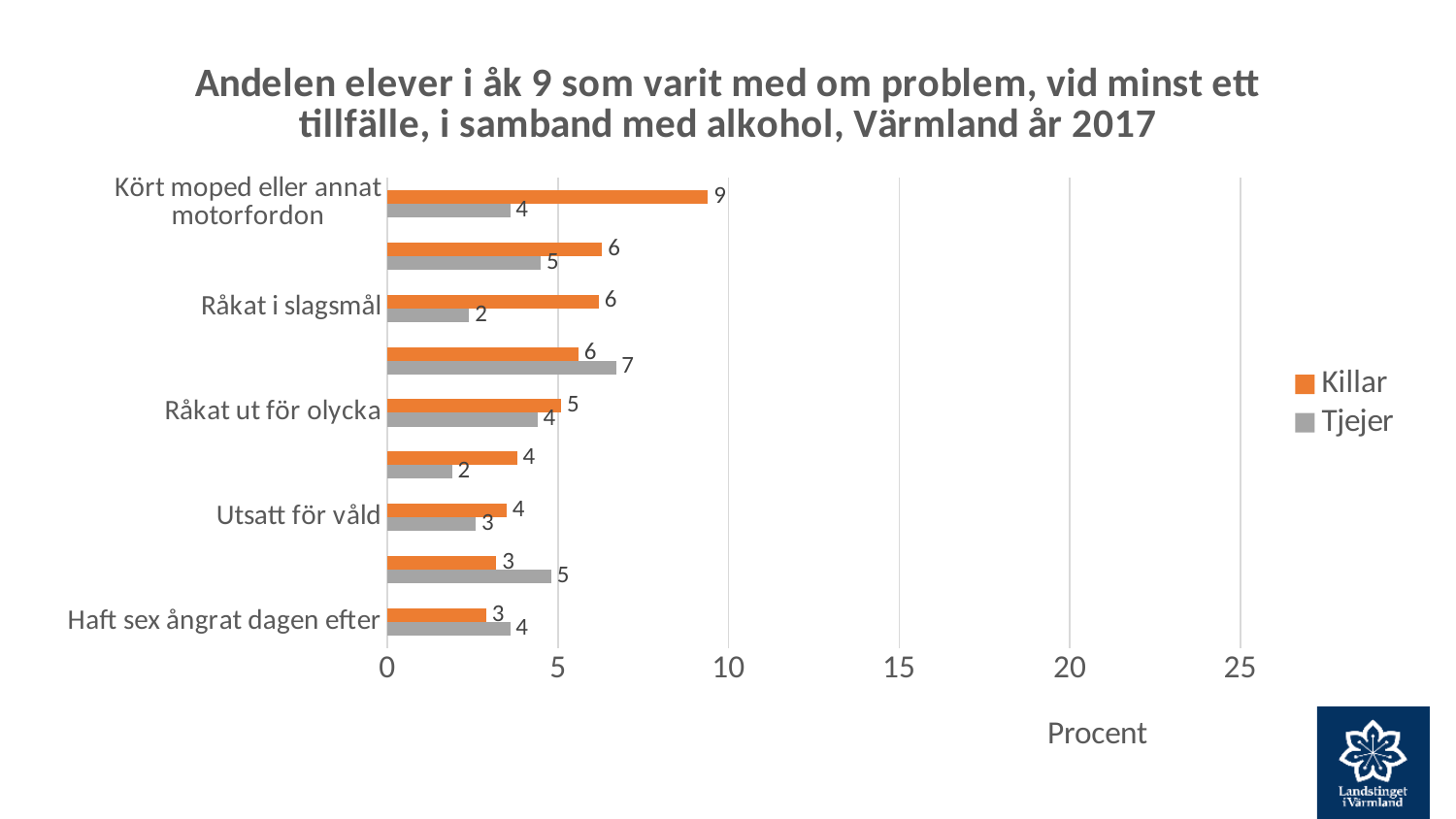
How many series does the legend list? 2 For 'Haft sex ångrat dagen efter', which series has the larger value, Killar or Tjejer? Tjejer What is the difference between Killar and Tjejer for 'Kört moped eller annat motorfordon'? 5 What is the label on the horizontal axis? Procent Which labeled category has the highest value for Killar? Kört moped eller annat motorfordon What is the value for Killar for 'Råkat i slagsmål'? 6 What is the value for Tjejer for 'Kört moped eller annat motorfordon'? 4 What is the value for Tjejer for 'Råkat i slagsmål'? 2 What is the value for Killar for 'Kört moped eller annat motorfordon'? 9 What is the value for Tjejer for 'Utsatt för våld'? 3 Is the value for Killar for 'Kört moped eller annat motorfordon' greater or less than 10? less What kind of chart is shown on the slide? bar chart